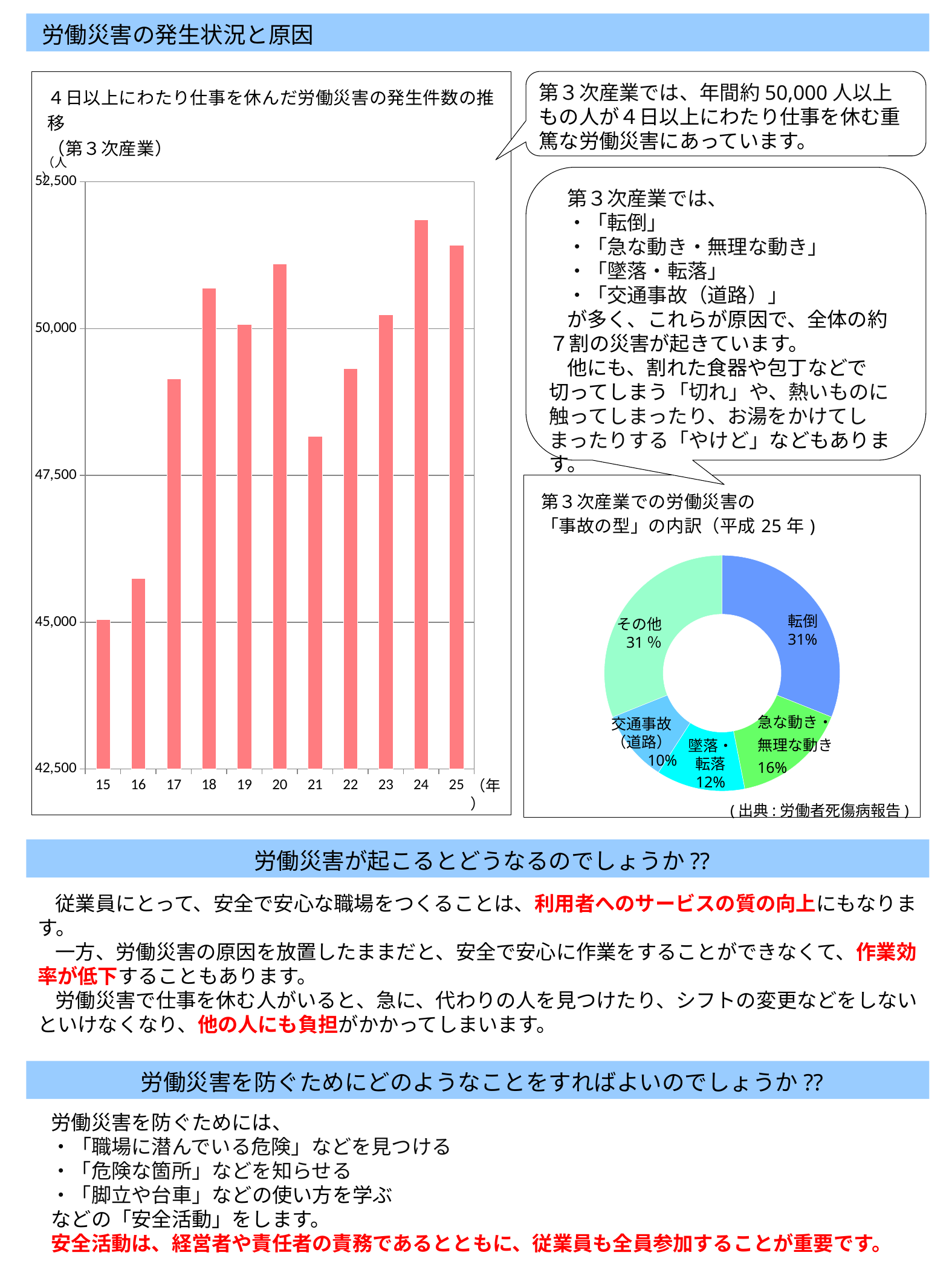
In the left bar chart, which year has the larger value, 24 or 25? 24 In the left bar chart, which year has the lowest value? 15 In the left bar chart, is the value for year 17 greater or less than 50,000? less In the left bar chart, how many years (bars) are plotted? 11 In the left bar chart, is the value for year 21 greater or less than 47,500? greater In the left bar chart, which year has the highest value? 24 What kind of chart is the left chart titled 「４日以上にわたり仕事を休んだ労働災害の発生件数の推移（第３次産業）」? bar chart In the left bar chart, is the value for year 18 greater or less than 50,000? greater In the right doughnut chart 「第３次産業での労働災害の「事故の型」の内訳（平成25年）」, what is the share for 転倒? 31% In the right doughnut chart, how many percentage points larger is 転倒 than 急な動き・無理な動き? 15 In the right doughnut chart, which category has the smallest share? 交通事故（道路） In the right doughnut chart, what is the share for 墜落・転落? 12%